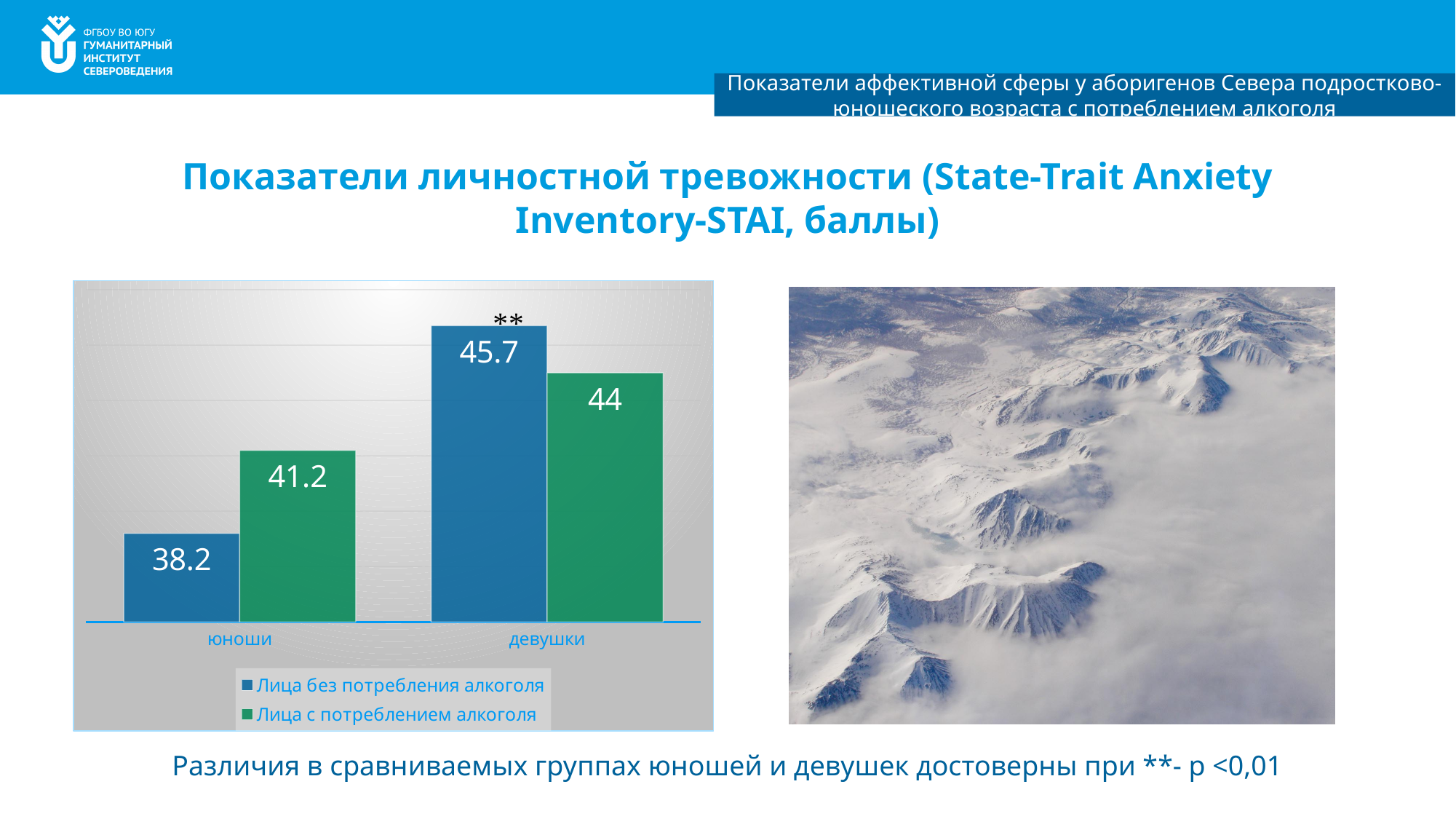
For юноши, which series has the larger value: Лица без потребления алкоголя or Лица с потреблением алкоголя? Лица с потреблением алкоголя What is the value for юноши in the series Лица с потреблением алкоголя? 41.2 Which bar has the highest value on the chart? девушки, Лица без потребления алкоголя How many series does the legend list? 2 What is the value for юноши in the series Лица без потребления алкоголя? 38.2 What kind of chart is shown on the slide? bar chart What is the value for девушки in the series Лица без потребления алкоголя? 45.7 What is the difference between the two values for девушки? 1.7 Which bar has the lowest value on the chart? юноши, Лица без потребления алкоголя What is the value for девушки in the series Лица с потреблением алкоголя? 44 How many categories are shown on the x axis? 2 What is the difference between the two values for юноши? 3